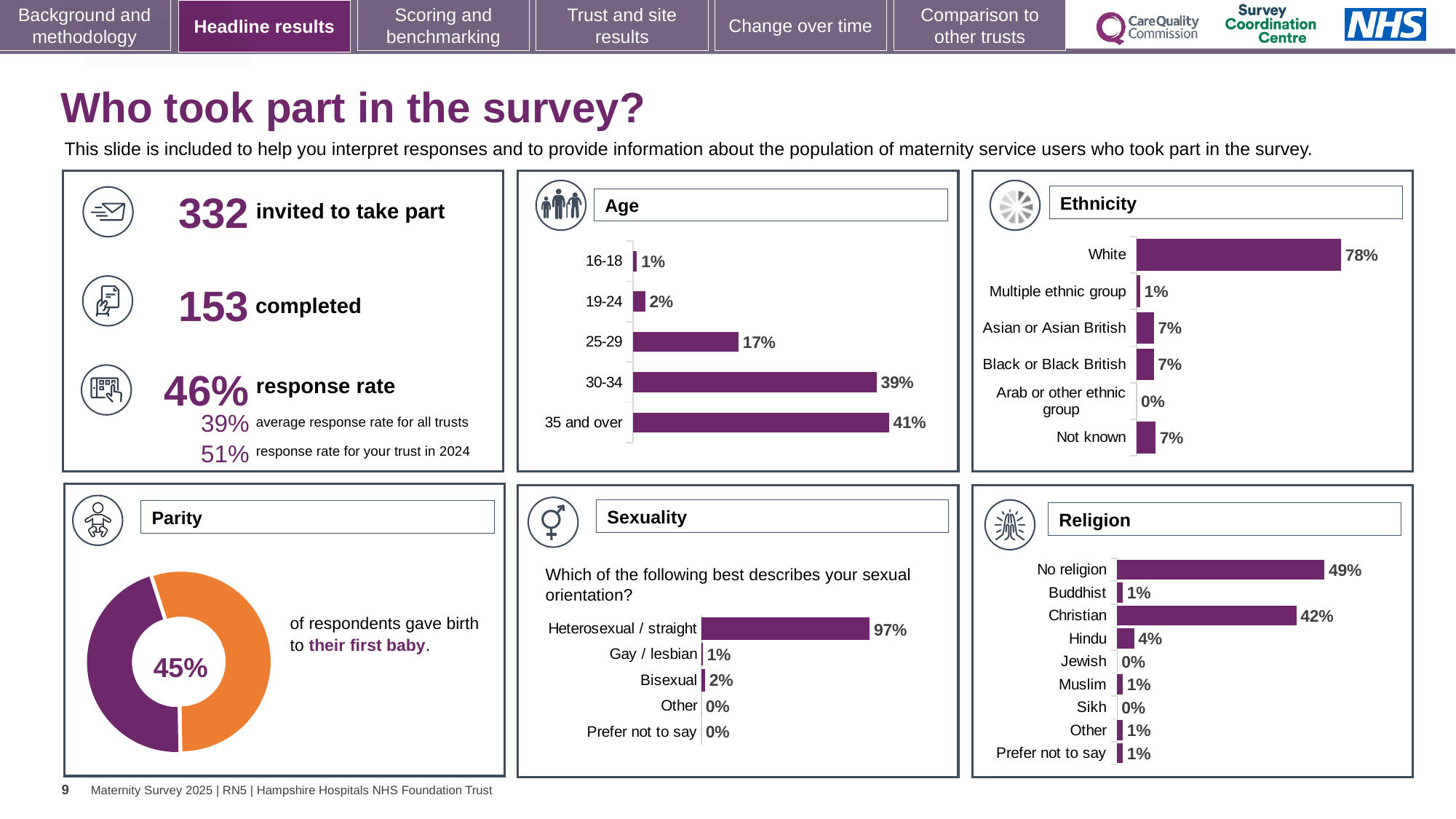
What kind of chart is the Parity chart? Doughnut (pie) chart In the Ethnicity chart, which category has the lowest value? Arab or other ethnic group In the Ethnicity chart, how many categories are shown? 6 In the Religion chart, what is the value for Christian? 42% In the Religion chart, what is the difference between the values for No religion and Christian? 7% In the Sexuality chart, which is larger, the value for Bisexual or the value for Gay / lesbian? Bisexual In the Sexuality chart, what is the value for Heterosexual / straight? 97% In the Ethnicity chart, what is the value for White? 78% In the Age chart, what is the difference between the values for 35 and over and 25-29? 24% In the Parity chart, what percentage of respondents gave birth to their first baby? 45% In the Age chart, what is the value for the 30-34 age group? 39% In the Age chart, which age group has the highest value? 35 and over